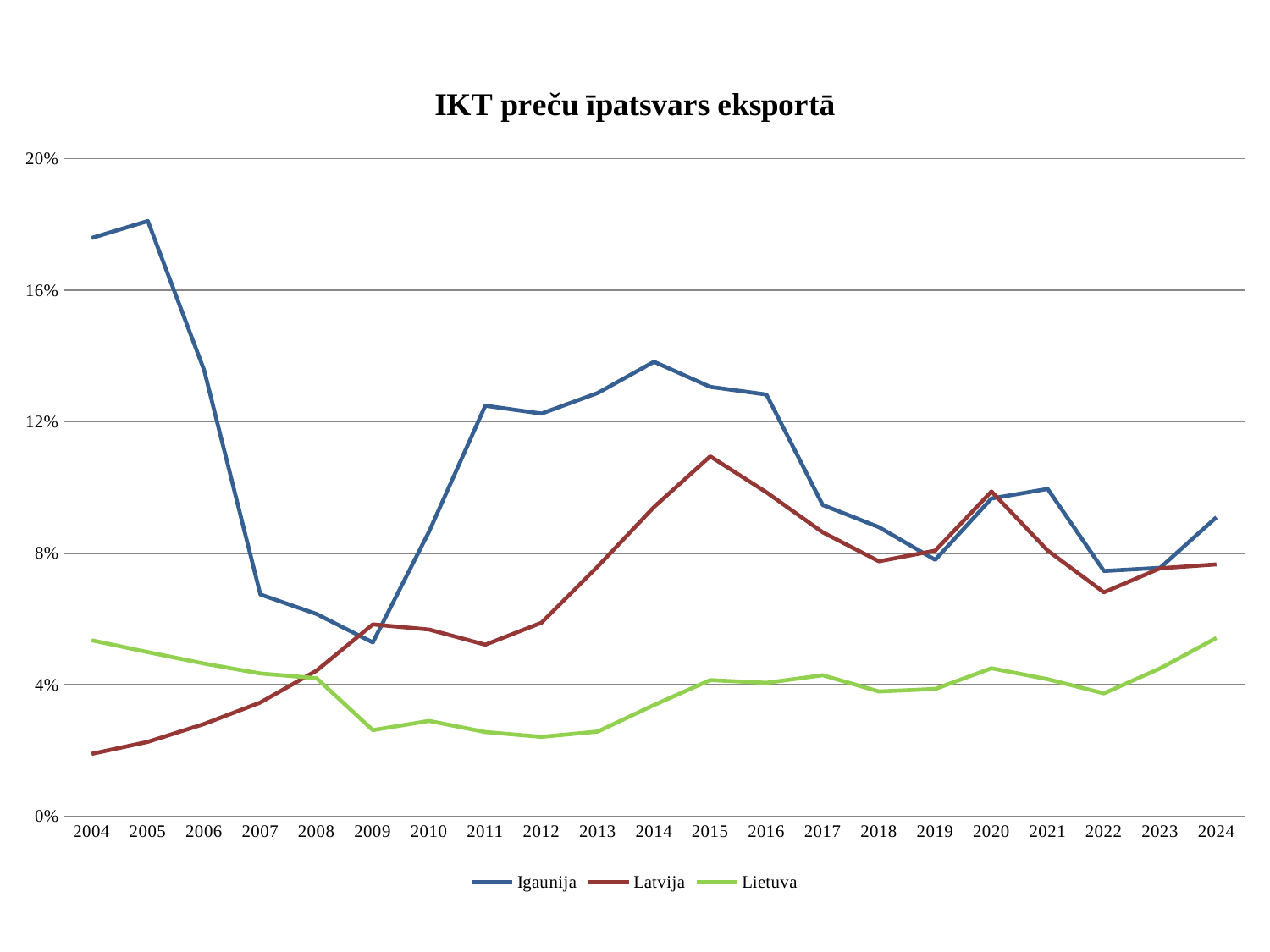
How many series does the legend list? 3 Is the value for Latvija in 2015 greater or less than 8%? greater Which series is drawn in green? Lietuva In which year does the Latvija series have its lowest value? 2004 Does the Igaunija series rise or fall from 2005 to 2007? fall Is the value for Latvija in 2004 greater or less than 4%? less Is the value for Igaunija in 2005 greater or less than 16%? greater What is the title of the chart? IKT preču īpatsvars eksportā In 2015, which series has the higher value, Latvija or Lietuva? Latvija In which year does the Igaunija series reach its highest value? 2005 How many years are plotted along the x axis? 21 What kind of chart is shown on the slide? line chart